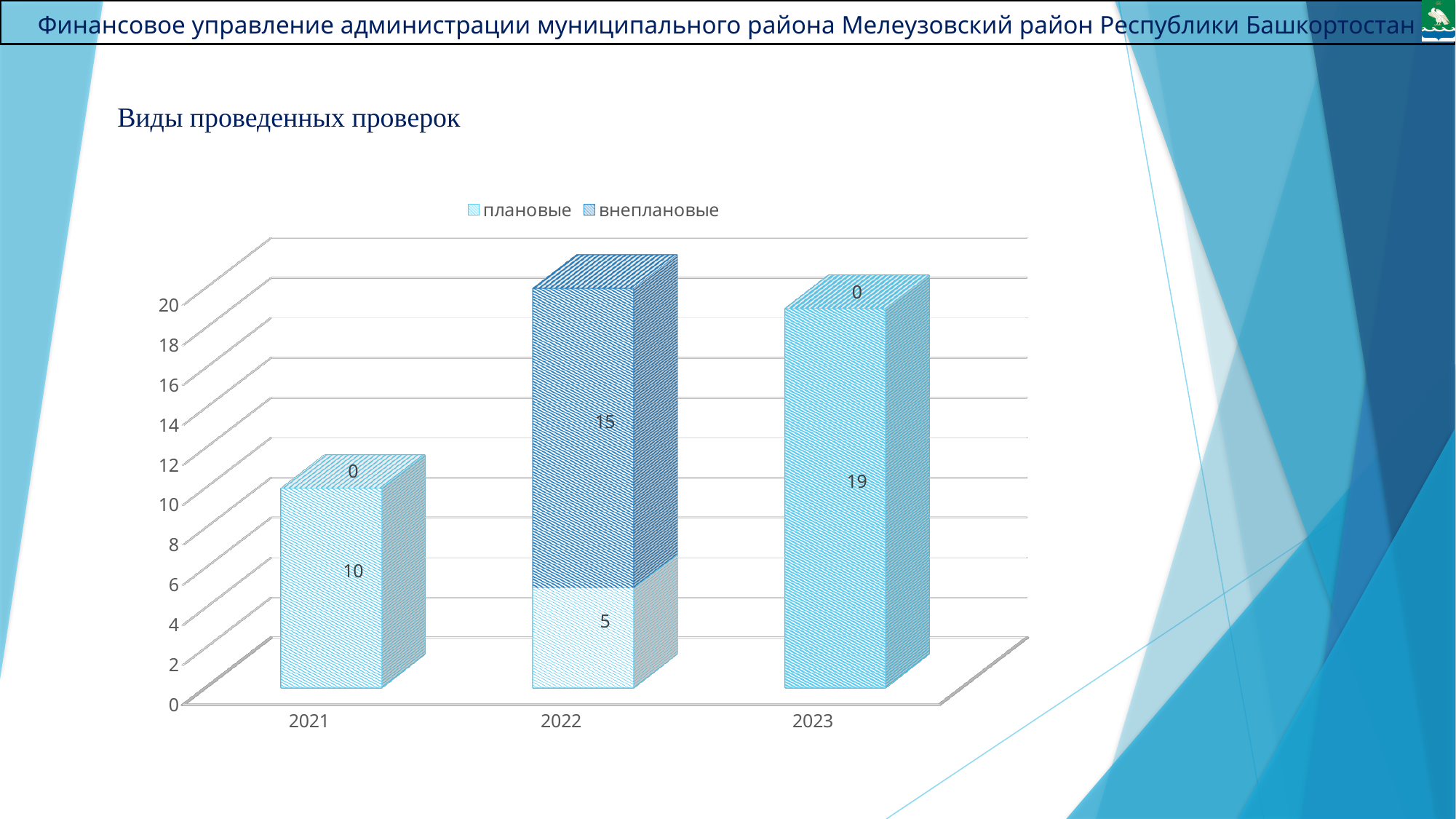
Which year has the lowest value for плановые? 2022 What is the difference between плановые in 2023 and плановые in 2021? 9 Which is larger in 2022: плановые or внеплановые? внеплановые How many years are shown on the x axis? 3 What is the value for внеплановые in 2021? 0 Which year has the highest value for плановые? 2023 What is the total of the stacked bar for 2022? 20 How many series does the legend list? 2 What is the value for внеплановые in 2022? 15 What is the value for плановые in 2023? 19 What kind of chart is shown on the slide? Stacked bar chart What is the value for плановые in 2022? 5